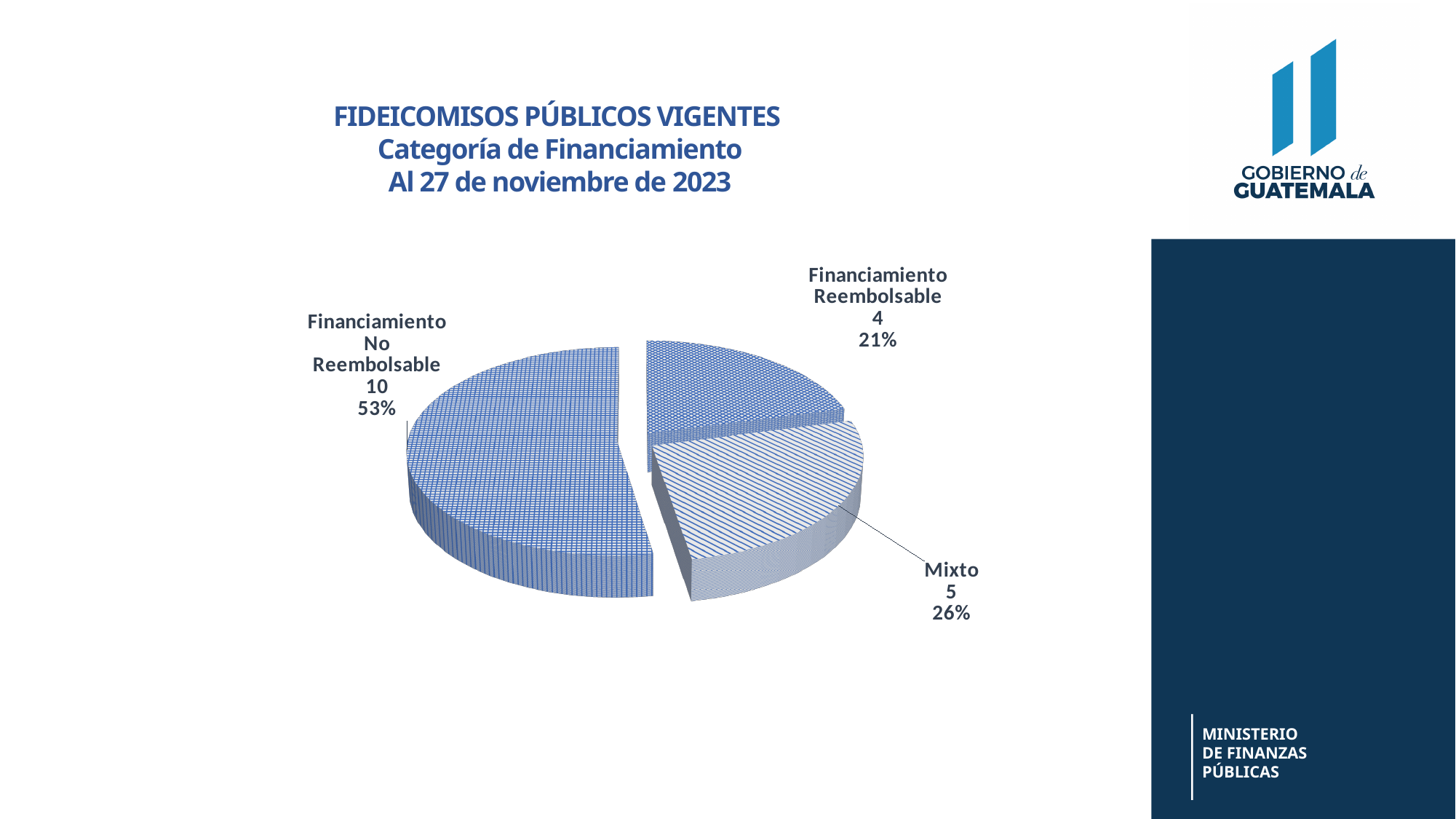
What share of the pie does Mixto represent? 26% Which is larger, the value for Mixto or the value for Financiamiento Reembolsable? Mixto What is the value for Financiamiento No Reembolsable? 10 What share of the pie does Financiamiento No Reembolsable represent? 53% Which category has the smallest slice? Financiamiento Reembolsable What share of the pie does Financiamiento Reembolsable represent? 21% How many slices does the pie chart have? 3 What is the difference between the values for Financiamiento No Reembolsable and Mixto? 5 What kind of chart is shown on the slide? Pie chart What is the value for Mixto? 5 Which category has the largest slice? Financiamiento No Reembolsable What is the value for Financiamiento Reembolsable? 4